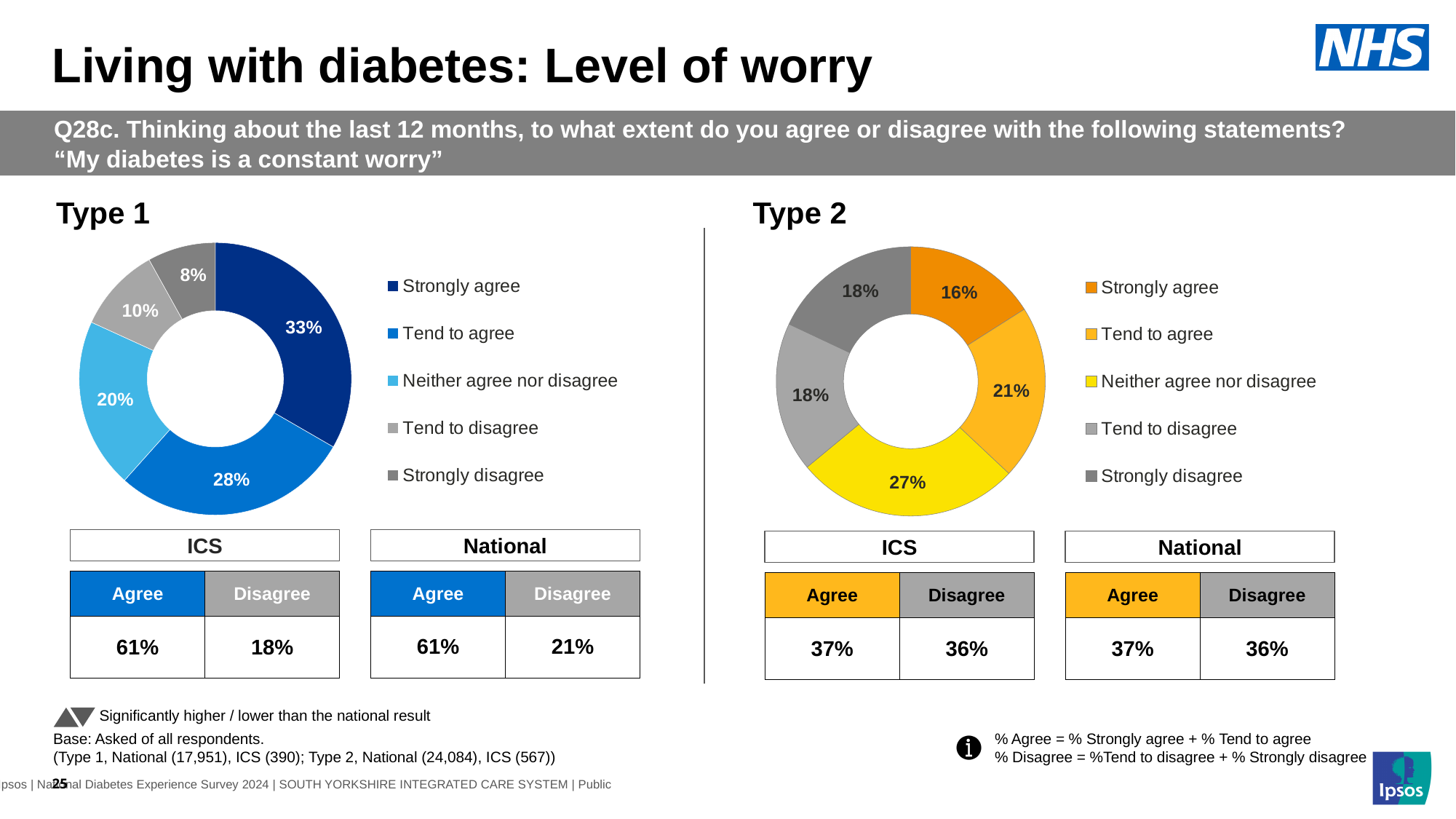
How many response categories does the legend of the Type 2 chart list? 5 In the Type 2 chart, what percentage of respondents said 'Tend to agree'? 21% In the Type 2 chart, which is larger: the 'Strongly agree' share or the 'Tend to agree' share? Tend to agree In the Type 1 chart, what percentage of respondents said 'Strongly agree'? 33% In the Type 1 chart, which response category has the smallest share? Strongly disagree In the Type 2 chart, what percentage of respondents said 'Neither agree nor disagree'? 27% In the Type 1 chart, what is the difference between the 'Strongly agree' and 'Tend to agree' shares? 5 percentage points In the Type 1 chart, which response category has the largest share? Strongly agree In the Type 2 chart, which response category has the largest share? Neither agree nor disagree In the Type 1 chart, what percentage of respondents said 'Neither agree nor disagree'? 20% What kind of chart is used for the Type 1 data? Pie (doughnut) chart In the Type 2 chart, which response category has the smallest share? Strongly agree